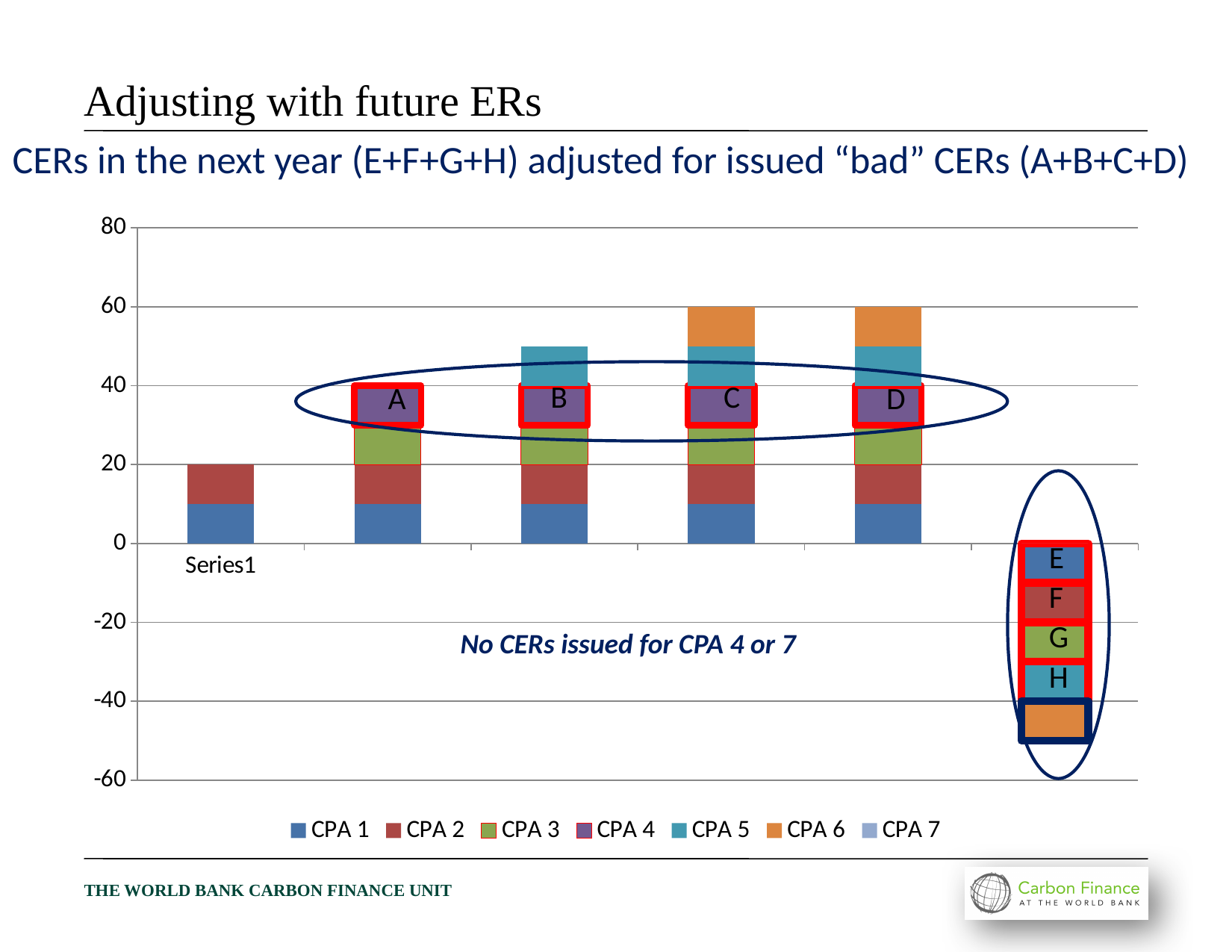
What is the total height of the Series1 bar? 20 How many stacked bars are plotted in the chart? 6 Is the total of the Series1 bar greater or less than 40? less Which is taller: the Series1 bar or the stacked bar containing segment A? the bar containing segment A What is the highest value shown on the vertical axis? 80 What kind of chart is shown on the slide? bar chart How many series does the legend list? 7 Is the bottom of the rightmost bar (segments E, F, G, H) greater or less than -40? less What text is written in the annotation inside the chart area? No CERs issued for CPA 4 or 7 Is the total of the stacked bar containing segment D greater or less than 40? greater